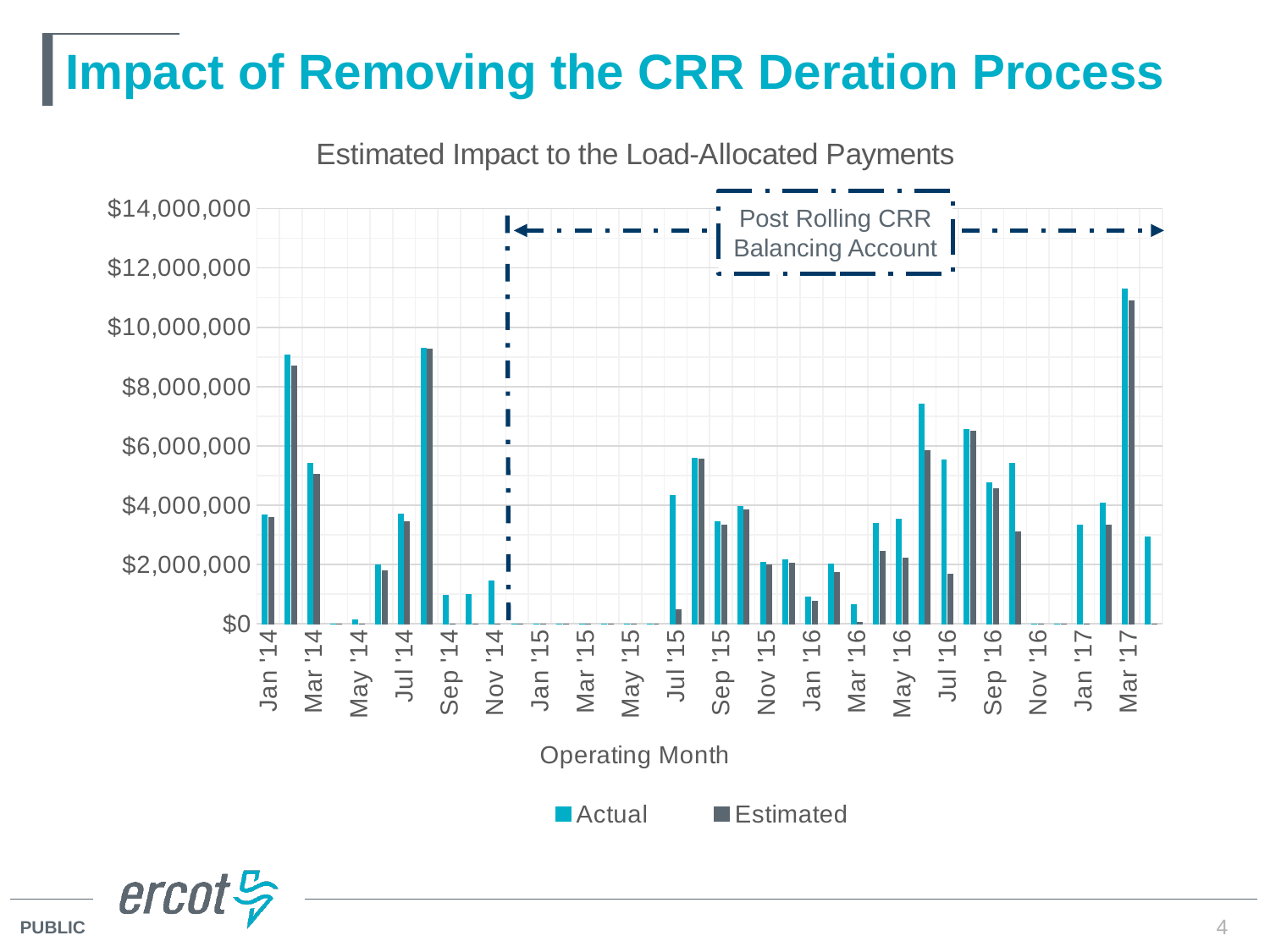
What kind of chart is shown on the slide? bar chart Is the Actual value for Sep '16 greater or less than $6,000,000? less What is the title of the chart? Estimated Impact to the Load-Allocated Payments Is the Actual value for Mar '17 greater or less than $10,000,000? greater Which operating month has the highest Actual value? Mar '17 Is the Estimated value for Jul '15 greater or less than $2,000,000? less How many series does the legend list? 2 Which is larger for Jul '16, the Actual value or the Estimated value? Actual What are the two series named in the legend? Actual and Estimated Which is larger, the Actual value for Mar '17 or the Actual value for Mar '14? Mar '17